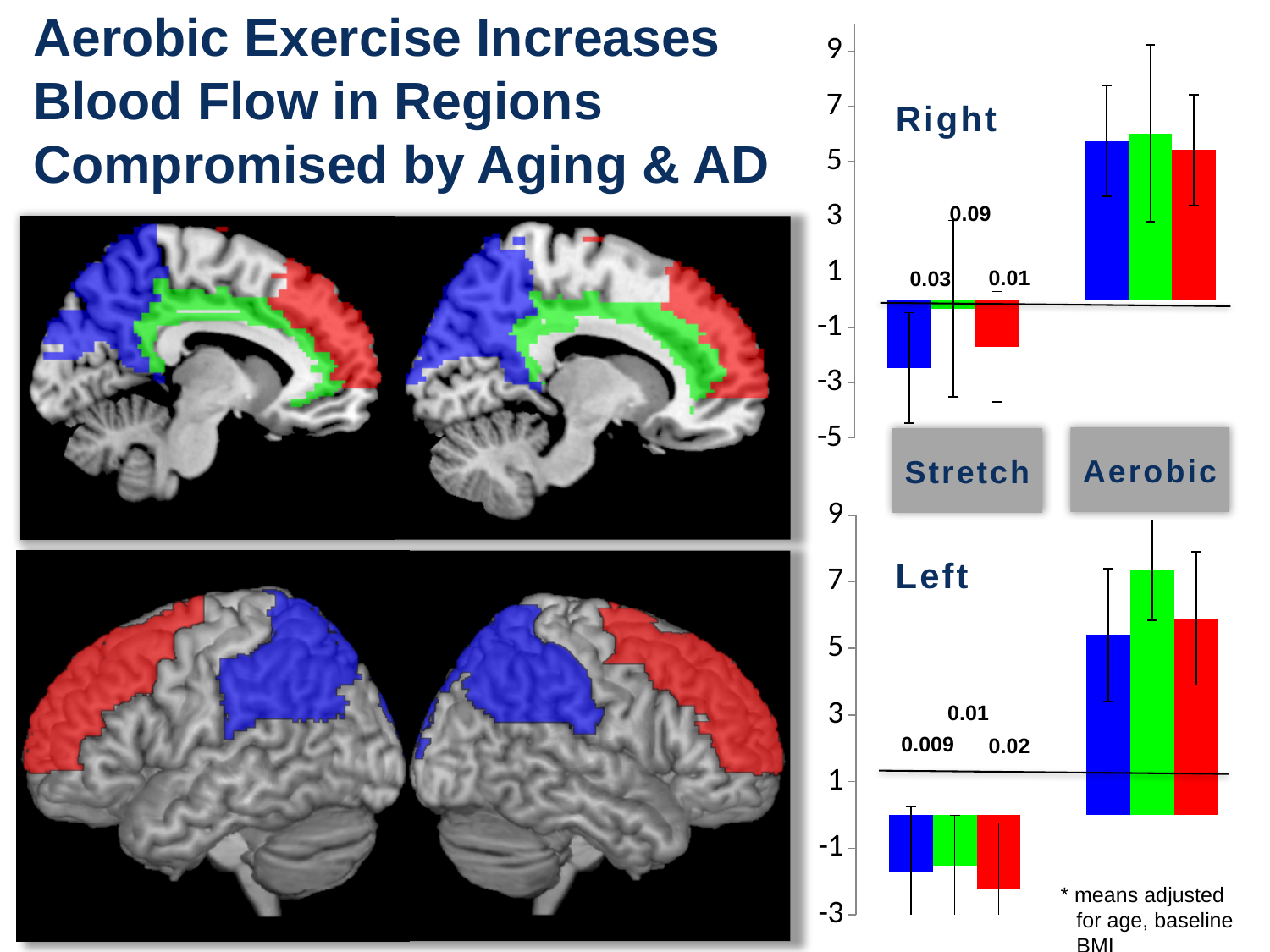
In the 'Left' chart, which coloured bar is the tallest for Aerobic? green In the 'Left' chart, is the value of the red Stretch bar greater or less than -1? less In the 'Left' chart, is the value of the green Aerobic bar greater or less than 5? greater What kind of chart is the 'Right' chart on the slide? bar chart In the 'Right' chart, do the bar values rise or fall going from Stretch to Aerobic? rise In the 'Right' chart, what value is printed above the green Stretch bar? 0.09 How many categories are shown on the x axis of the 'Right' chart? 2 What are the two category labels shared by the 'Right' and 'Left' charts? Stretch and Aerobic In the 'Left' chart, what value is printed above the blue Stretch bar? 0.009 In the 'Right' chart, is the value of the blue Stretch bar greater or less than -1? less In the 'Right' chart, which is larger: the blue bar for Stretch or the blue bar for Aerobic? Aerobic